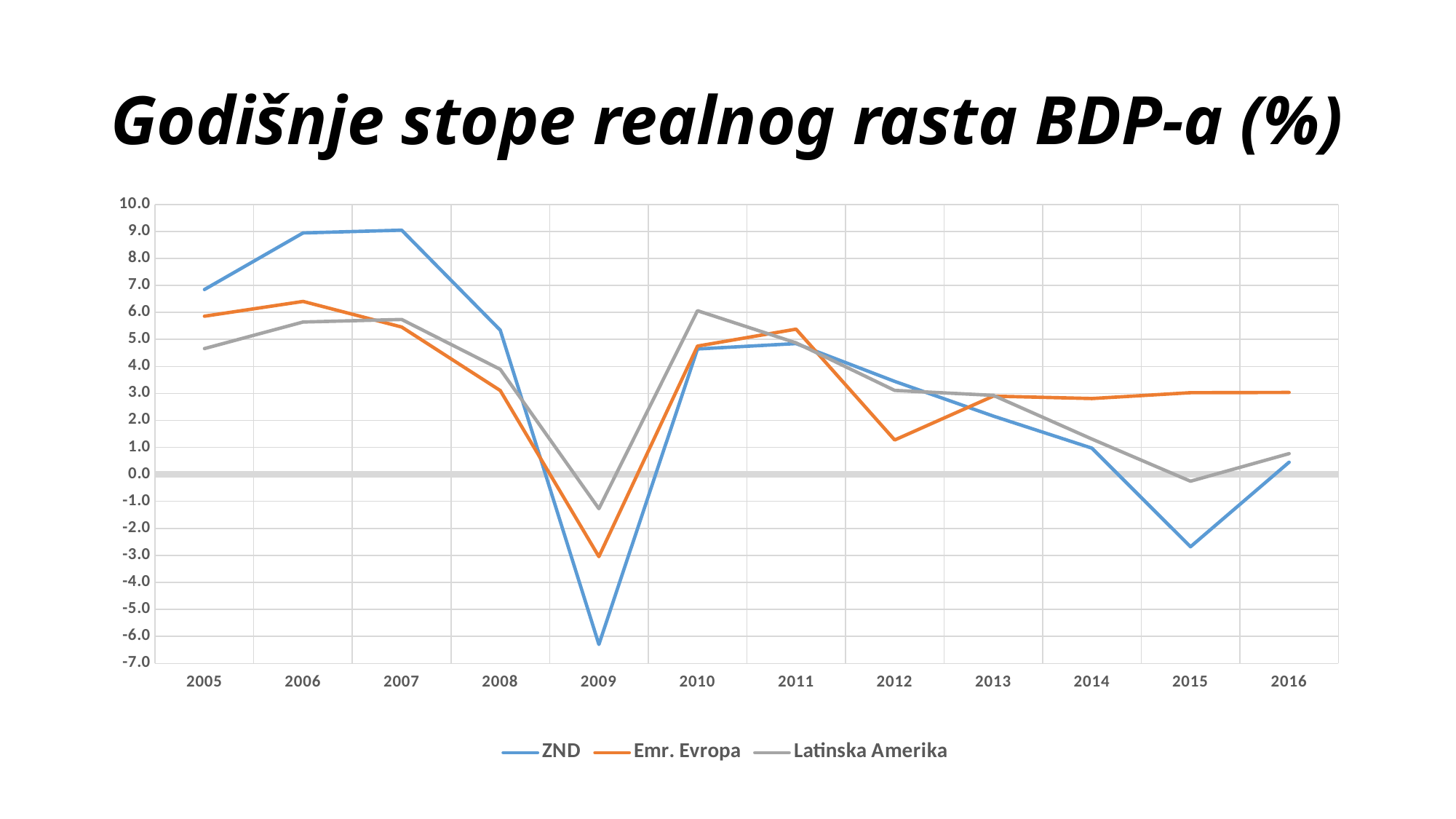
Is the value for ZND in 2009 greater or less than -5.0? less What is the title of the chart? Godišnje stope realnog rasta BDP-a (%) Is the value for Emr. Evropa in 2012 greater or less than 2.0? less How many years are plotted along the x axis? 12 In which year does the ZND series reach its lowest value? 2009 Does the ZND series rise or fall from 2011 to 2015? fall How many series does the legend list? 3 Is the value for ZND in 2006 greater or less than 8.0? greater In 2009, which series has the higher value: ZND or Emr. Evropa? Emr. Evropa In which year does the Emr. Evropa series reach its lowest value? 2009 In which year does the Emr. Evropa series reach its highest value? 2006 What kind of chart is shown on the slide? line chart